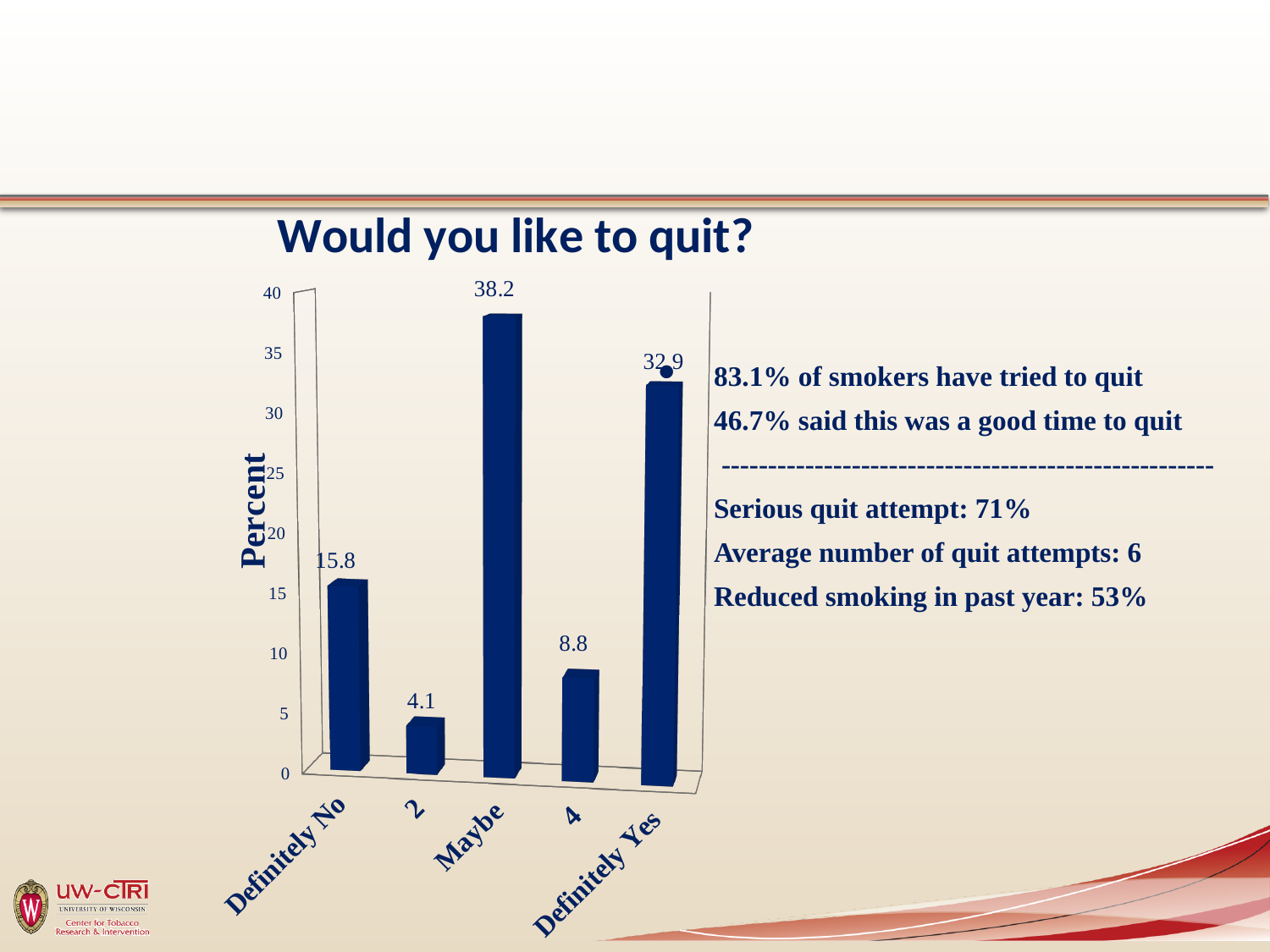
What kind of chart is shown on the slide? Bar chart How many categories are shown on the x axis? 5 Which is larger, the value for "Definitely No" or the value for "4"? Definitely No What is the value for "Definitely Yes"? 32.9 What is the value for "Definitely No"? 15.8 What is the value for "Maybe"? 38.2 Which category has the highest value? Maybe Which category has the lowest value? 2 What is the difference between the values for "Maybe" and "Definitely Yes"? 5.3 What is the difference between the values for "Definitely No" and "4"? 7 What is the value for category "2"? 4.1 What is the label of the vertical axis? Percent